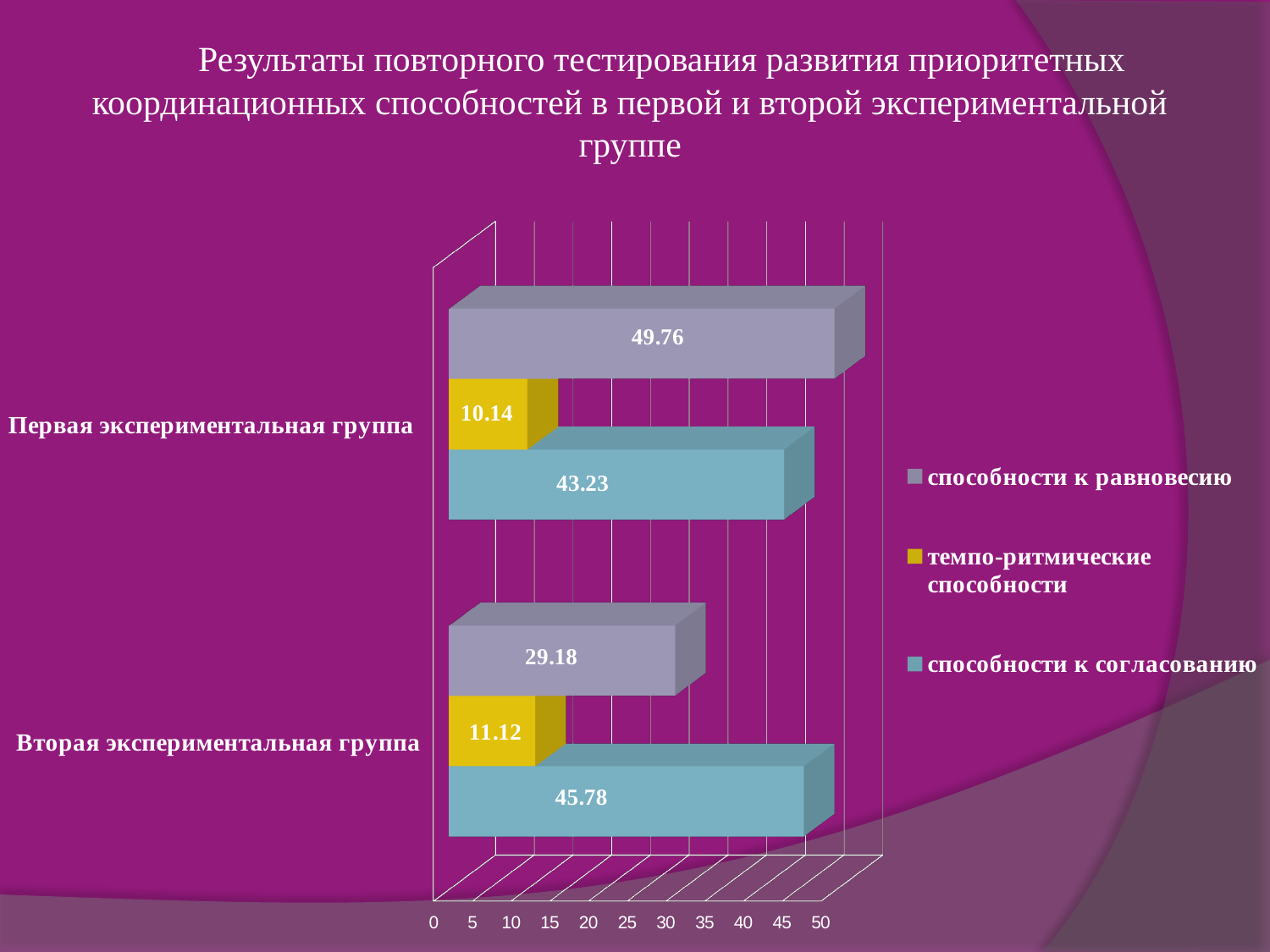
Which group has the larger value for способности к согласованию? Вторая экспериментальная группа Which series has the lowest value in the Первая экспериментальная группа? темпо-ритмические способности What is the value for способности к равновесию in the Первая экспериментальная группа? 49.76 Which series has the highest value in the Вторая экспериментальная группа? способности к согласованию What is the difference between the способности к равновесию values of the Первая and Вторая экспериментальная группа? 20.58 How many series does the legend list? 3 What is the value for способности к согласованию in the Первая экспериментальная группа? 43.23 What is the value for темпо-ритмические способности in the Вторая экспериментальная группа? 11.12 How many groups (categories) are shown on the chart? 2 What kind of chart is shown on the slide? Bar chart What colour are the bars for темпо-ритмические способности? Yellow What is the value for способности к равновесию in the Вторая экспериментальная группа? 29.18